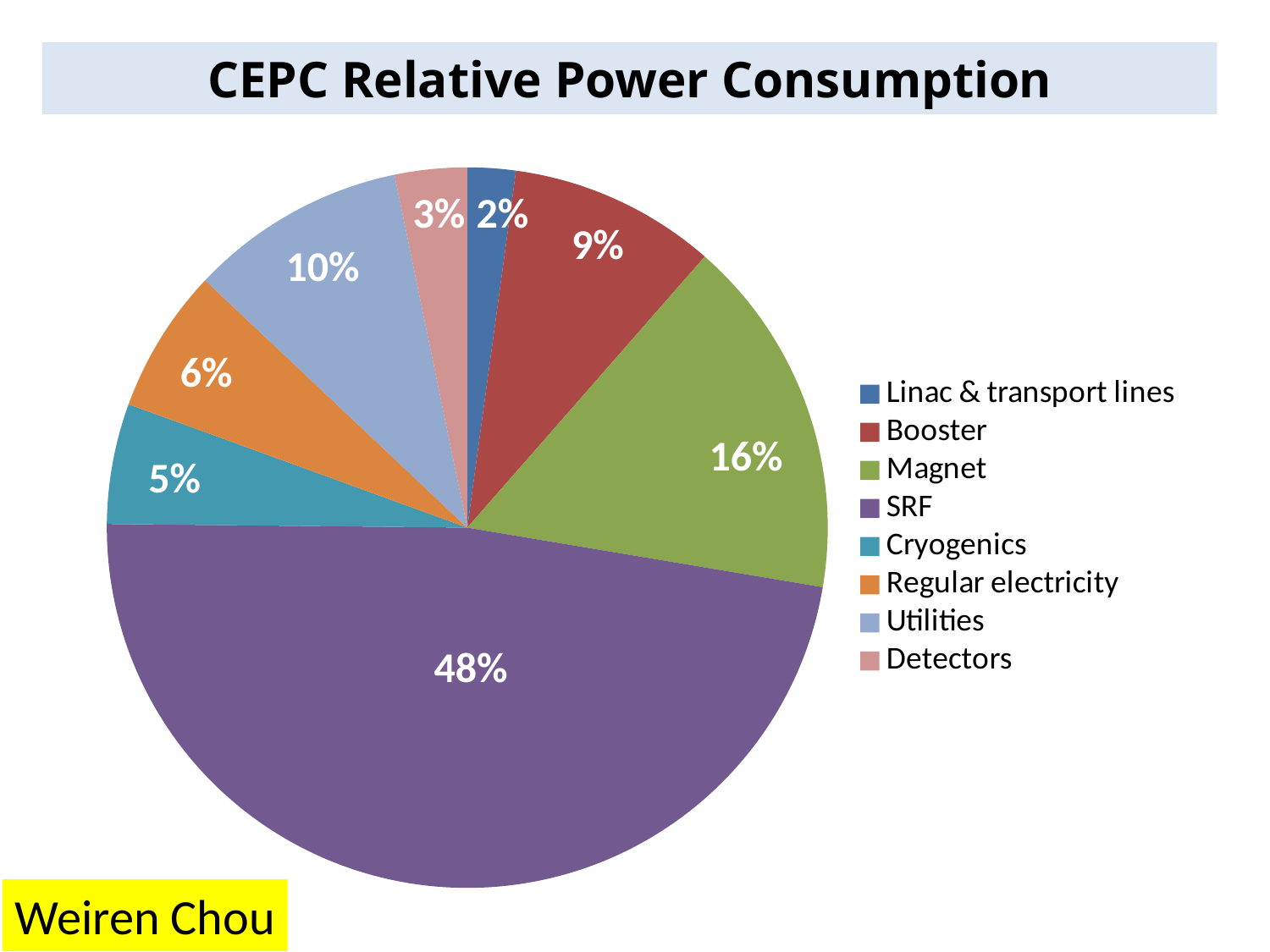
What share of power consumption does SRF account for? 48% What share of power consumption does Magnet account for? 16% How many categories does the legend list? 8 Which category has the largest share of power consumption? SRF What share of power consumption does Booster account for? 9% Which category has the smallest share of power consumption? Linac & transport lines What is the difference between the shares of Magnet and Regular electricity? 10% What is the title of the chart? CEPC Relative Power Consumption What type of chart is shown on the slide? pie chart Which has a larger share, Utilities or Detectors? Utilities